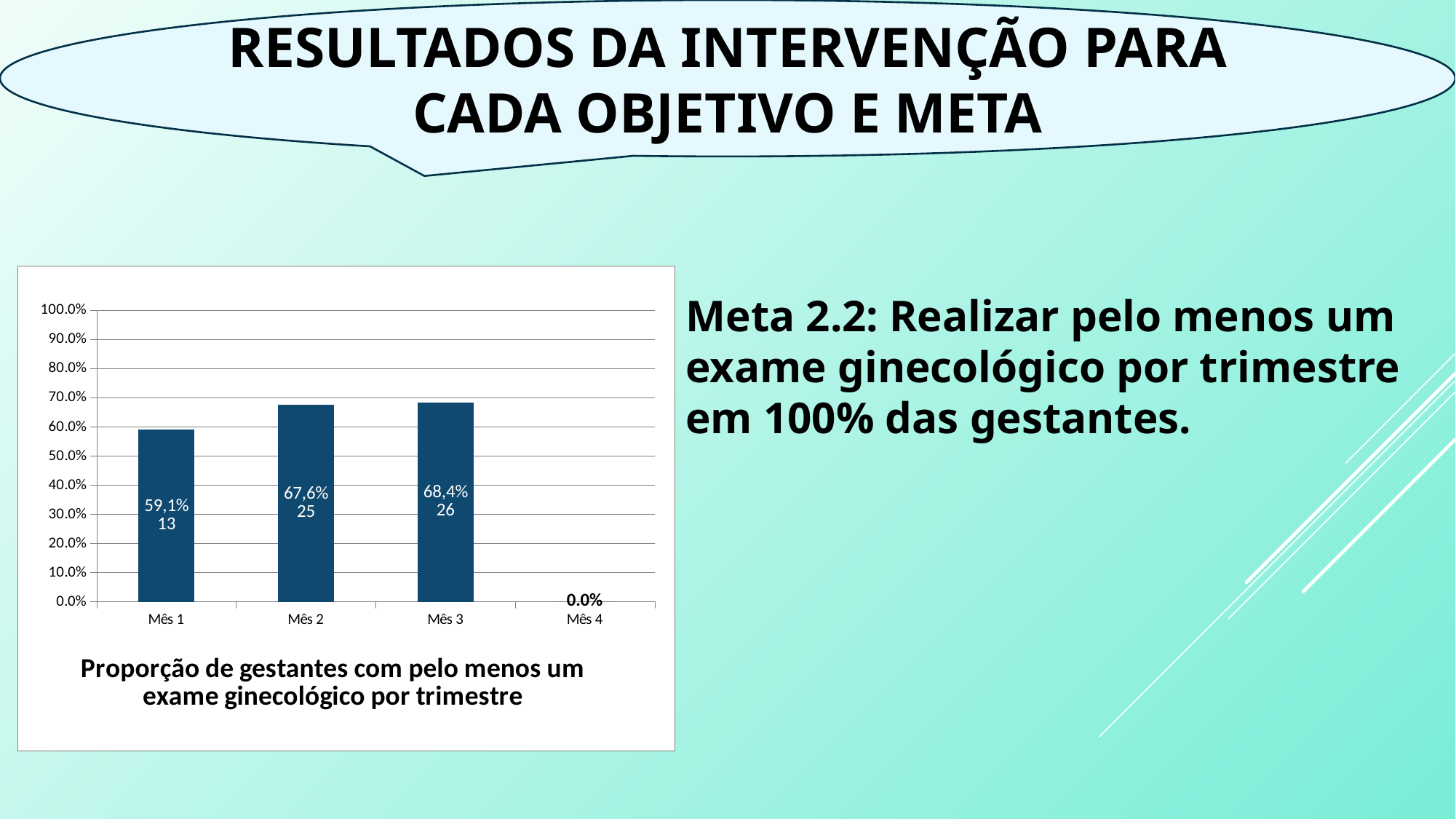
What is the difference in percentage points between Mês 2 and Mês 1? 8,5 What is the title of the chart? Proporção de gestantes com pelo menos um exame ginecológico por trimestre How many months (categories) are shown on the x axis? 4 Which month has the highest percentage? Mês 3 Which is larger, the value for Mês 1 or the value for Mês 2? Mês 2 What percentage is shown for Mês 1? 59,1% What percentage is shown for Mês 3? 68,4% What count is printed on the bar for Mês 2? 25 How many more gestantes are counted in Mês 3 than in Mês 1? 13 Which month has the lowest value? Mês 4 What value is shown for Mês 4? 0.0% What kind of chart is shown on the slide? Bar chart